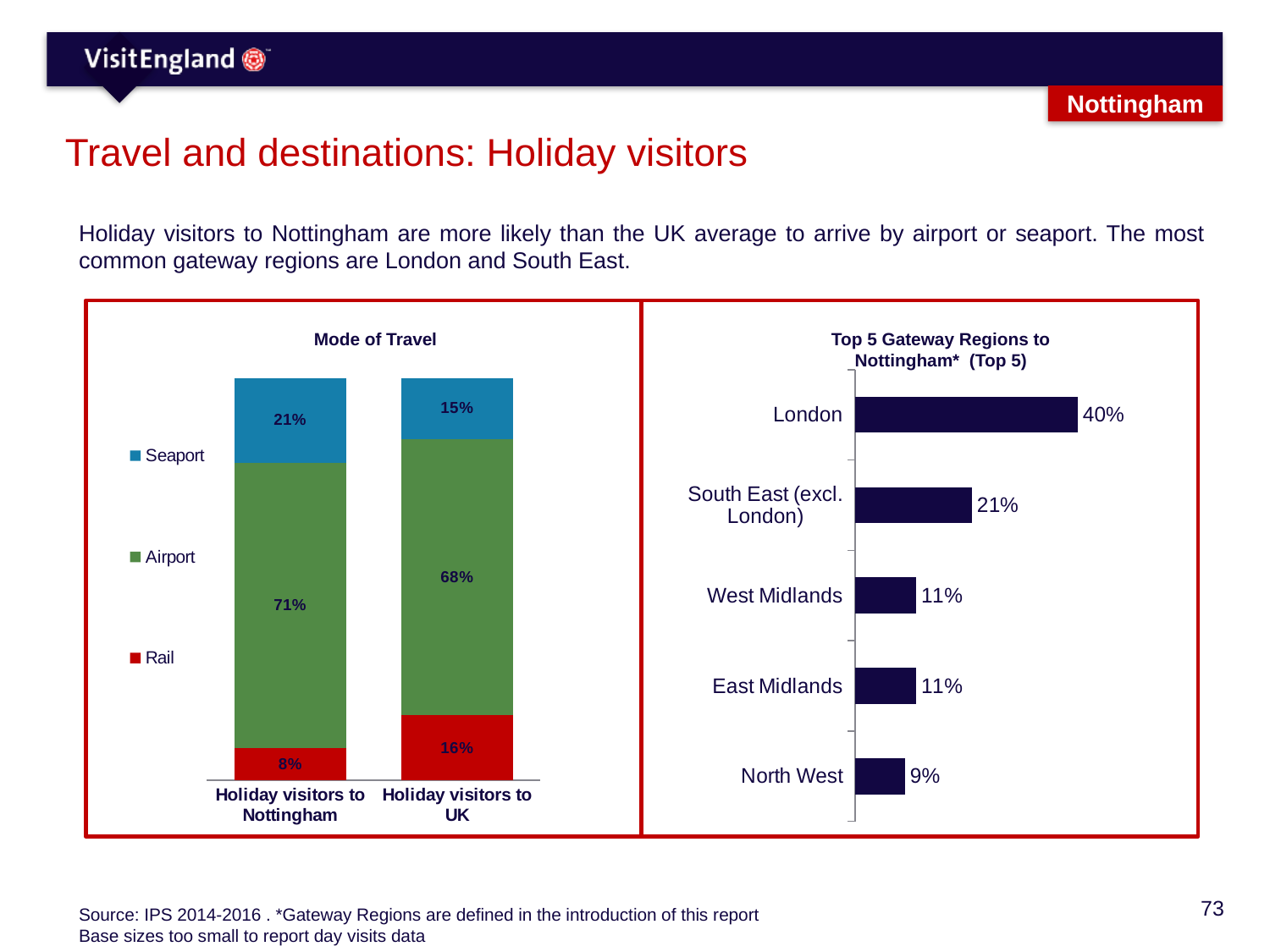
In the 'Mode of Travel' chart, what is the difference between the airport share for holiday visitors to Nottingham and for holiday visitors to the UK? 3 percentage points In the 'Top 5 Gateway Regions to Nottingham' chart, which region has the lowest value? North West In the 'Mode of Travel' chart, what percentage of holiday visitors to the UK arrive by rail? 16% In the 'Mode of Travel' chart, how many series does the legend list? 3 What kind of chart is the 'Top 5 Gateway Regions to Nottingham' chart? Bar chart In the 'Top 5 Gateway Regions to Nottingham' chart, how many regions are shown? 5 In the 'Mode of Travel' chart, which is larger: the rail share for holiday visitors to Nottingham or for holiday visitors to the UK? Holiday visitors to UK In the 'Mode of Travel' chart, what is the seaport share for holiday visitors to Nottingham? 21% In the 'Top 5 Gateway Regions to Nottingham' chart, what is the difference between London and South East (excl. London)? 19 percentage points In the 'Mode of Travel' chart, what percentage of holiday visitors to Nottingham arrive by airport? 71% In the 'Top 5 Gateway Regions to Nottingham' chart, what is the value for London? 40% In the 'Mode of Travel' chart, what is the total of the stacked bar for holiday visitors to Nottingham? 100%